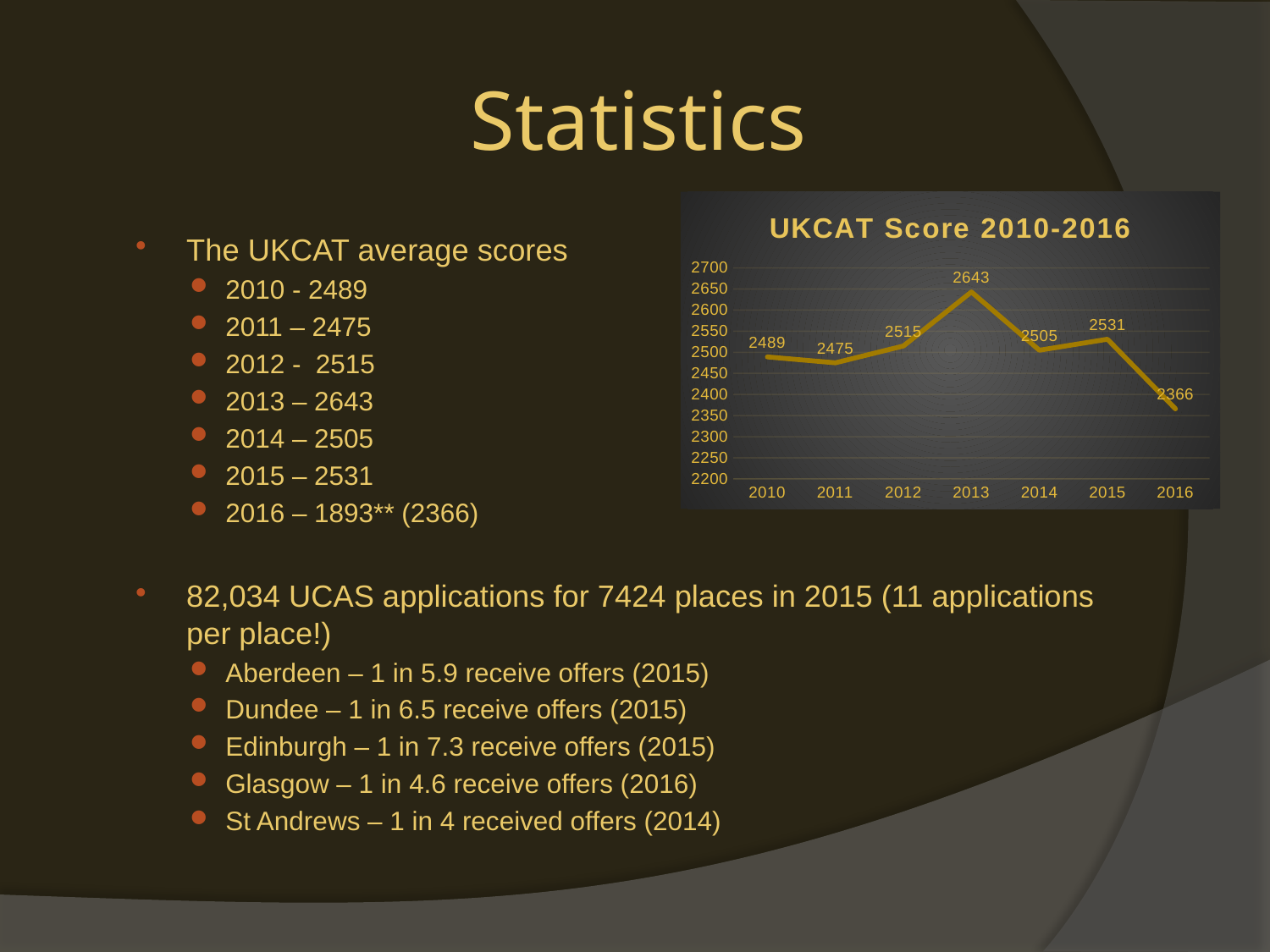
What is the UKCAT score for 2013 in the chart? 2643 Is the UKCAT score for 2016 greater or less than 2400? less How many years are plotted in the UKCAT Score chart? 7 Which year has the highest UKCAT score in the chart? 2013 Which year has a higher UKCAT score, 2014 or 2015? 2015 What is the difference between the UKCAT scores for 2015 and 2016? 165 What is the UKCAT score for 2011 in the chart? 2475 What is the difference between the UKCAT scores for 2013 and 2012? 128 What kind of chart is used to show the UKCAT scores? line chart Which year has the lowest UKCAT score in the chart? 2016 What is the UKCAT score for 2016 in the chart? 2366 What is the title of the chart on the slide? UKCAT Score 2010-2016